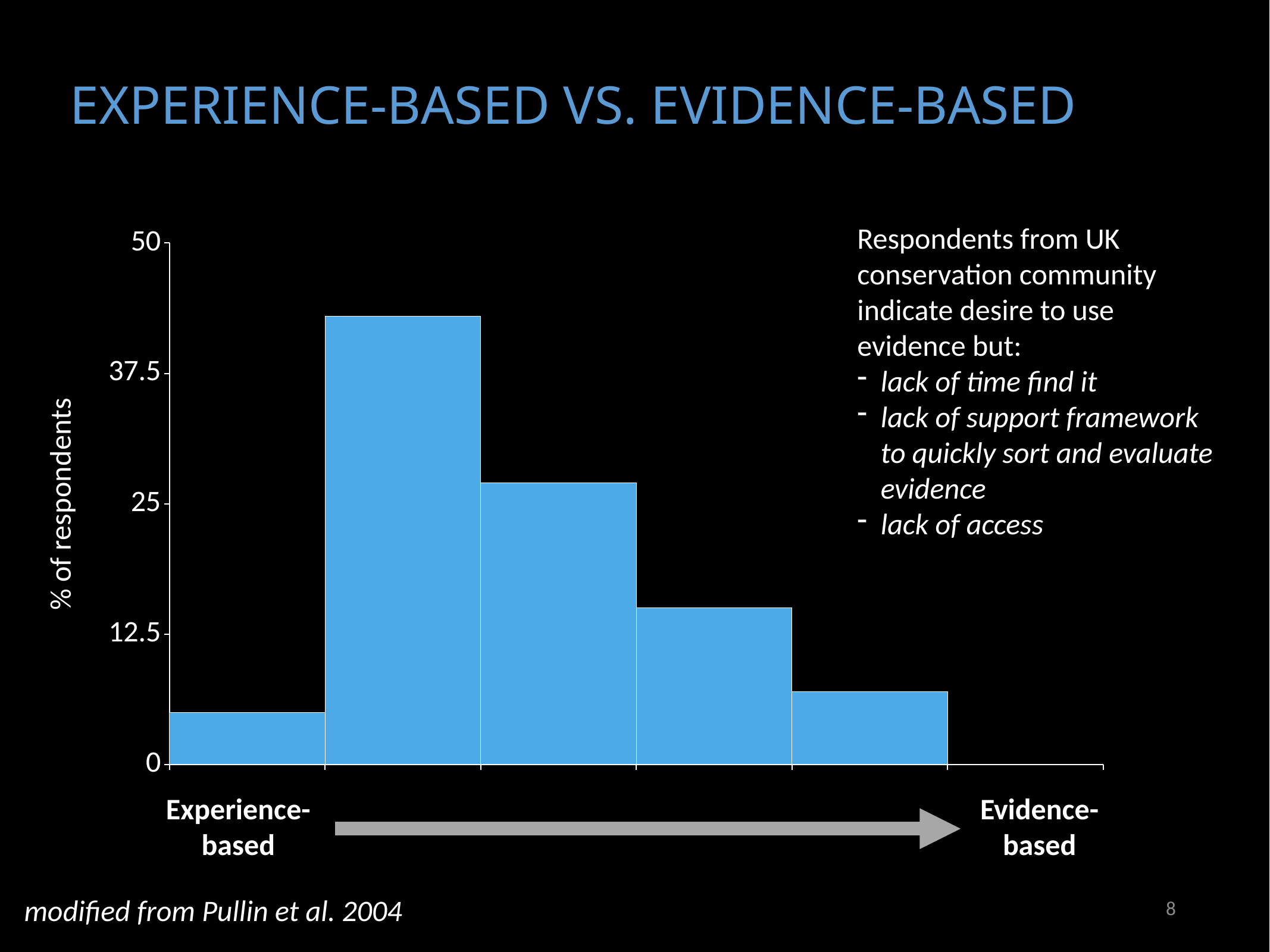
What is the highest tick value shown on the vertical axis? 50 Is the value of the second bar from the left greater or less than 37.5? greater Which bar is the shortest: the first, second, third, fourth or fifth from the left? first Which is larger: the second bar from the left or the third bar from the left? second bar from the left What is the label of the vertical axis of the chart? % of respondents Is the value of the third bar from the left greater or less than 25? greater What kind of chart is shown on the slide? bar chart Is the value of the fourth bar from the left greater or less than 25? less Which bar is the tallest: the first, second, third, fourth or fifth from the left? second Which is larger: the rightmost bar (nearest 'Evidence-based') or the leftmost bar (nearest 'Experience-based')? rightmost bar How many bars are plotted in the chart? 5